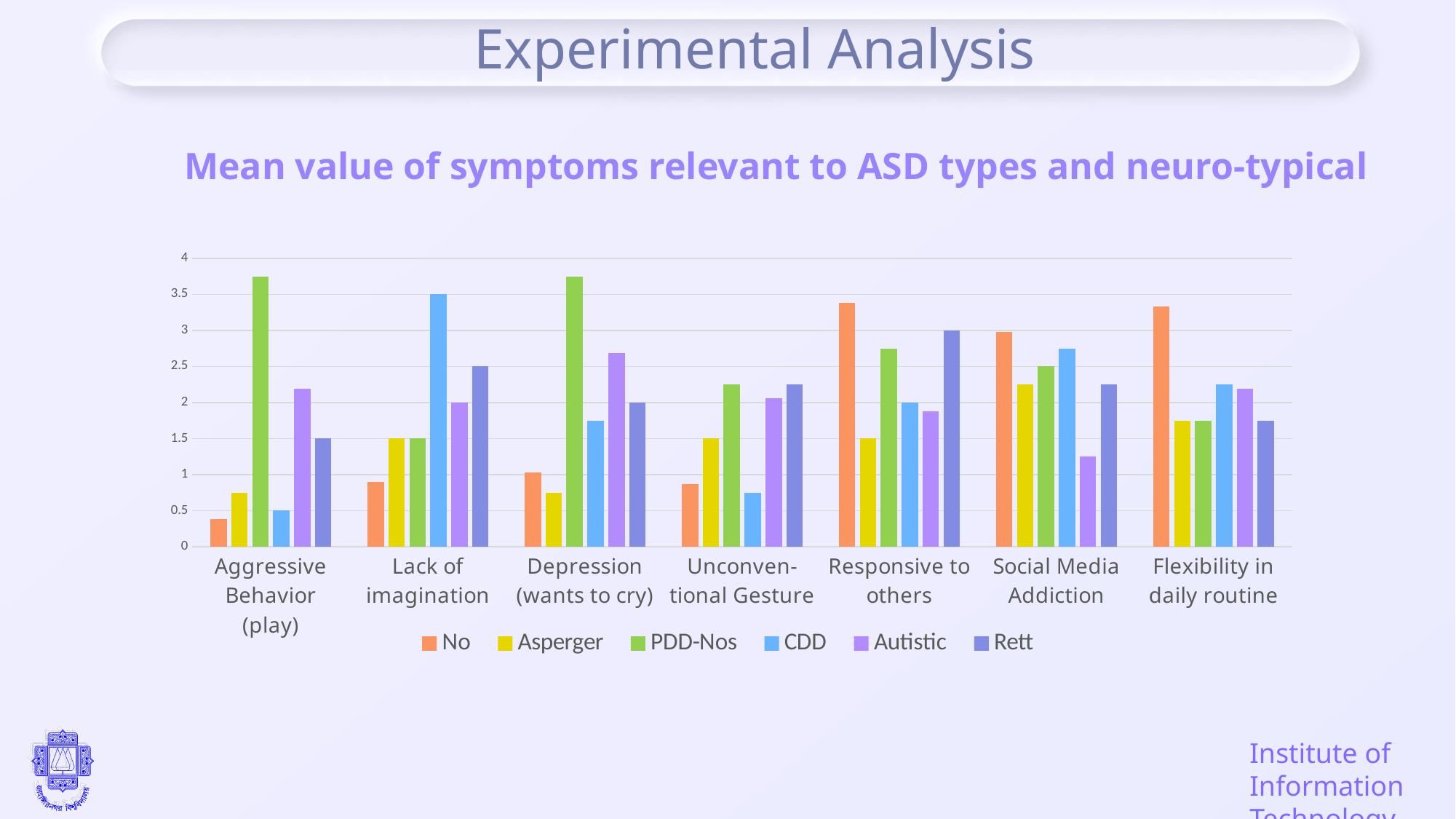
How many symptom categories are shown on the x axis? 7 What is the value for Rett in the Lack of imagination category? 2.5 What is the value for Rett in the Responsive to others category? 3 Is the value for No in Flexibility in daily routine greater or less than 3? greater Which series has the highest value for Lack of imagination? CDD How many series does the legend list? 6 What is the title of the chart? Mean value of symptoms relevant to ASD types and neuro-typical In the Responsive to others category, which is larger: No or Asperger? No What is the value for CDD in the Lack of imagination category? 3.5 Which series has the lowest value for Aggressive Behavior (play)? No Which series has the highest value for Aggressive Behavior (play)? PDD-Nos What kind of chart is shown on the slide? bar chart